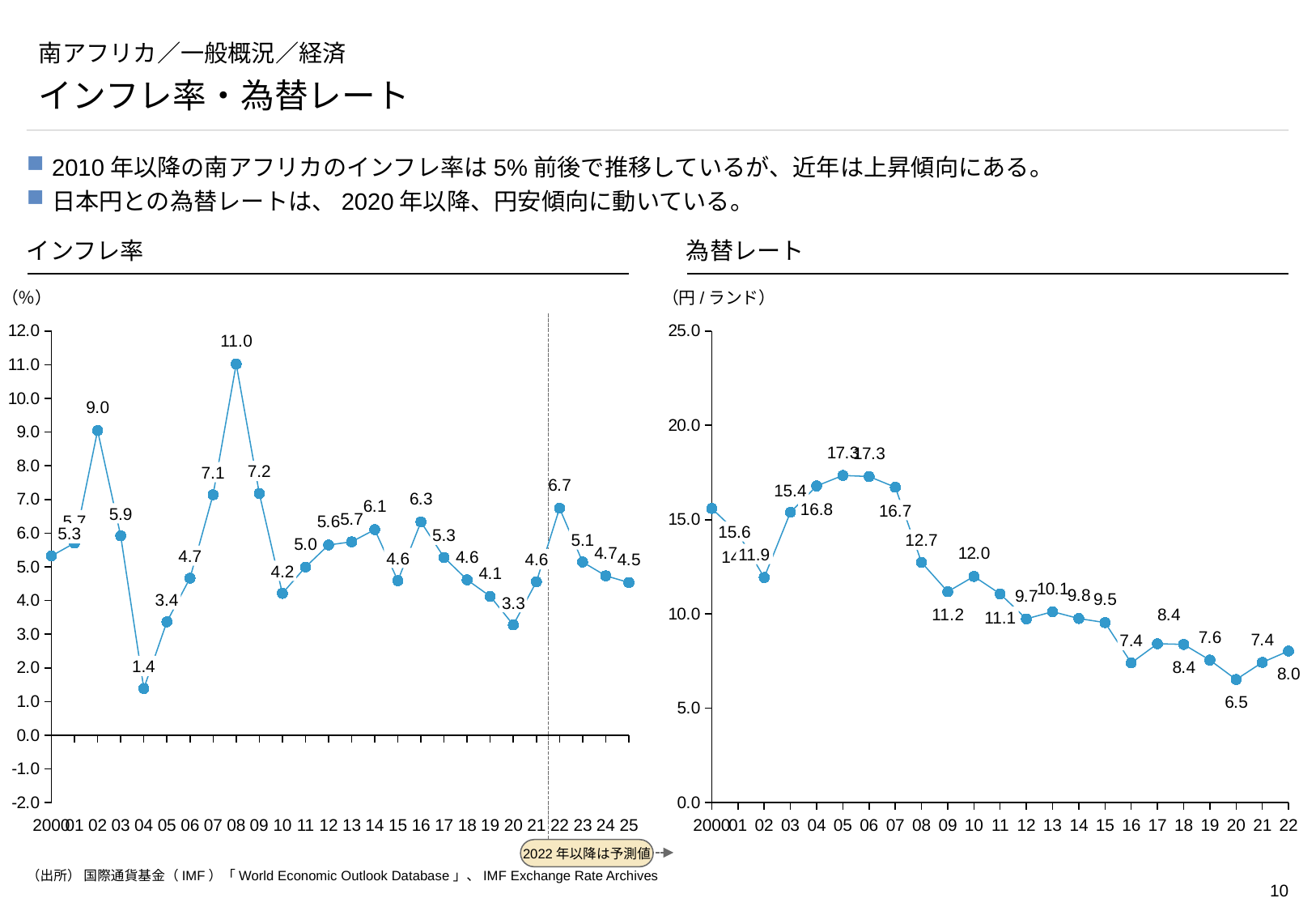
In the 為替レート chart, do the values generally rise or fall from 2007 to 2020? fall In the 為替レート chart, which year has the lowest exchange rate? 2020 In the 為替レート chart, what is the exchange rate for 2020? 6.5 In the 為替レート chart, which is larger, the value for 2010 or the value for 2012? 2010 In the インフレ率 chart, what is the inflation rate for 2025? 4.5 In the インフレ率 chart, is the value for 2002 greater or less than 8.0? greater What type of chart is the 為替レート chart? line chart In the 為替レート chart, what is the difference between the 2022 value and the 2021 value? 0.6 In the インフレ率 chart, what is the difference between the 2022 value and the 2020 value? 3.4 In the インフレ率 chart, which year has the highest inflation rate? 2008 In the インフレ率 chart, what is the inflation rate for 2008? 11.0 In the インフレ率 chart, which year has the lowest inflation rate? 2004